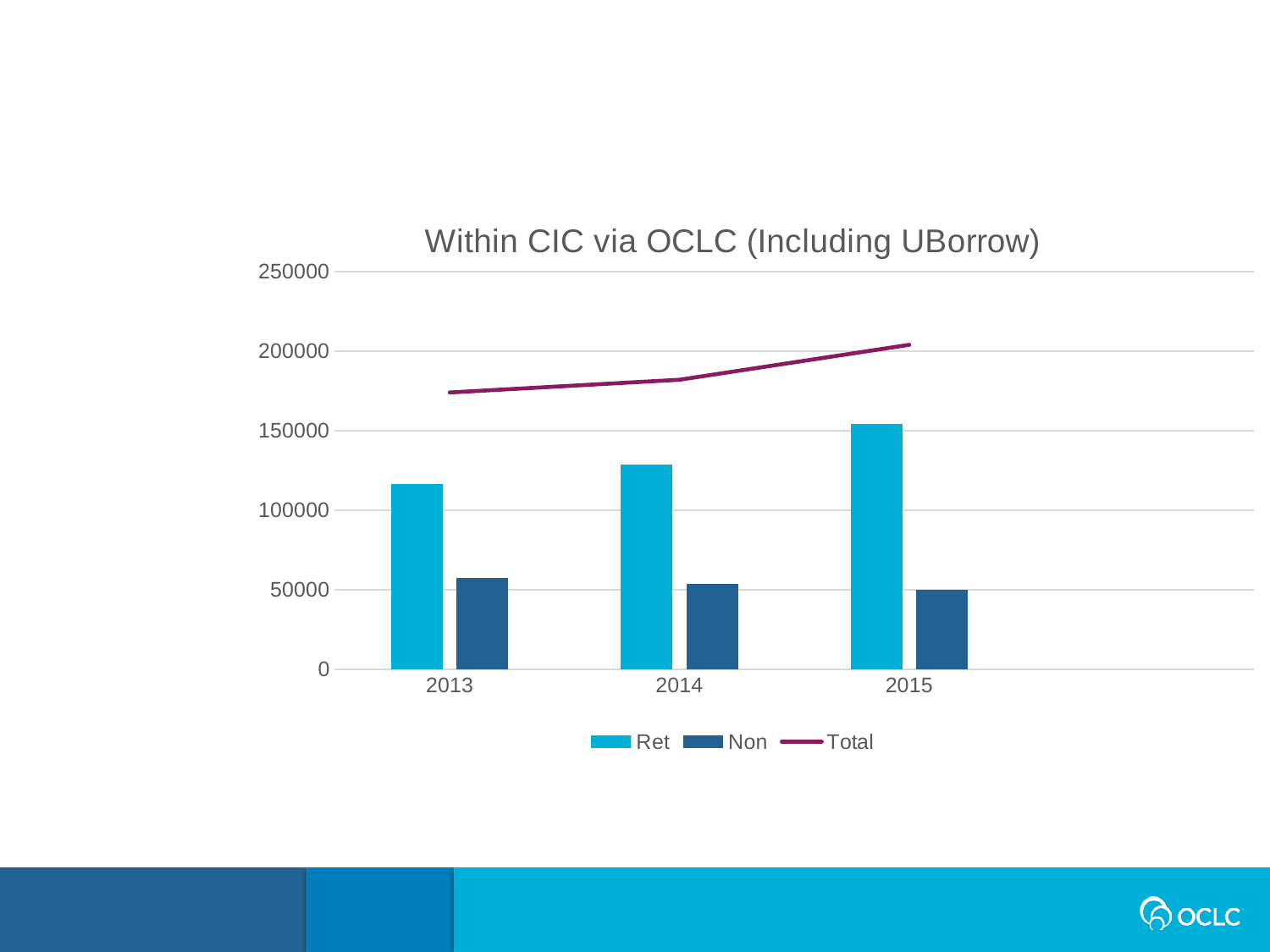
In 2015, which is larger, Ret or Non? Ret Is the Non value for 2013 greater or less than 50000? greater What kind of chart is this? Bar chart with a line series Is the Ret value for 2014 greater or less than 150000? less How many years are shown on the x axis? 3 Is the Ret value for 2013 greater or less than 100000? greater How many series does the legend list? 3 Which year has the highest Ret value? 2015 Does the Total line rise or fall from 2013 to 2015? rises What is the title of the chart? Within CIC via OCLC (Including UBorrow) Which year has the lowest Ret value? 2013